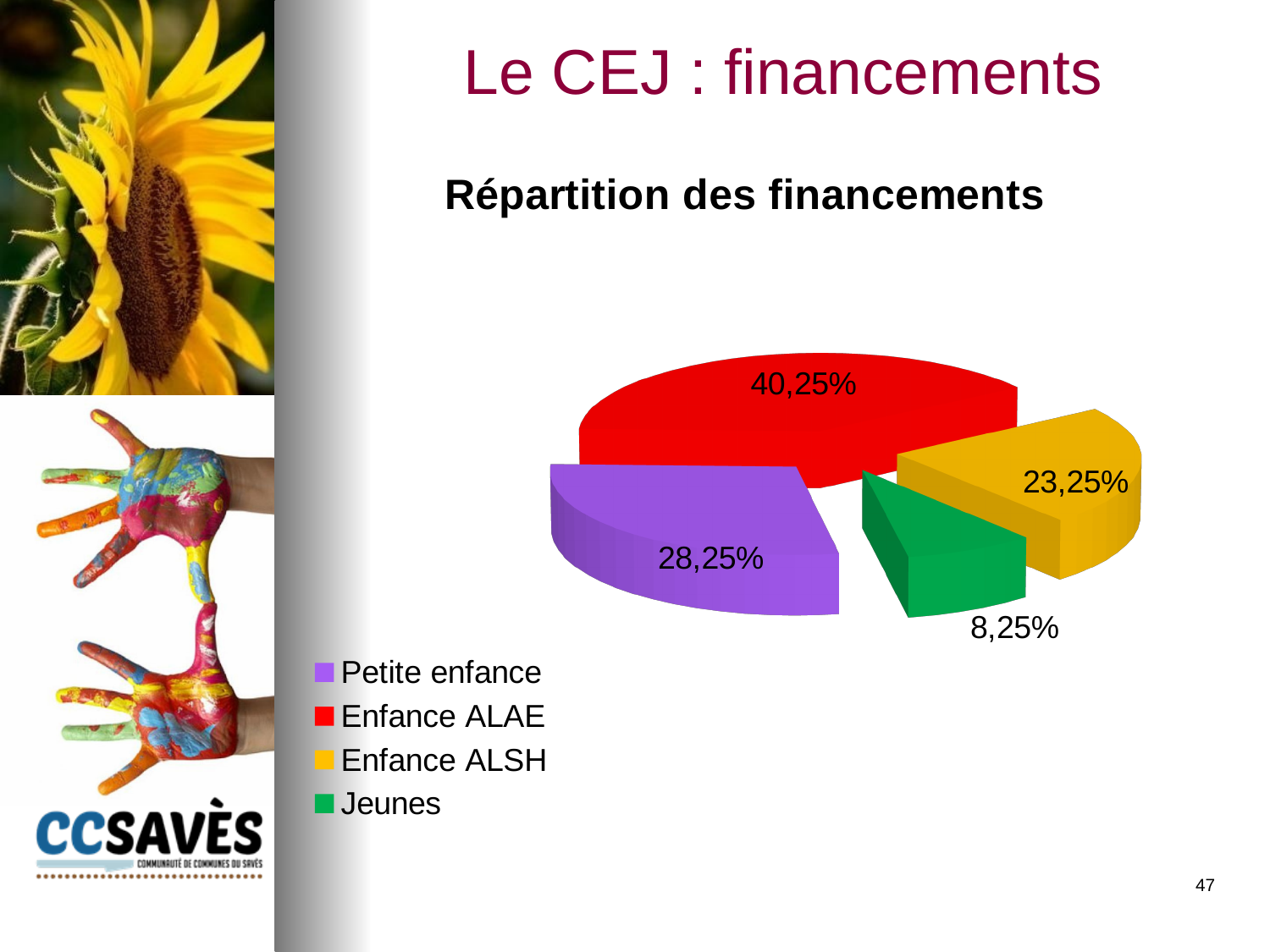
What is the share for Jeunes? 8,25% What is the share for Petite enfance? 28,25% What is the share for Enfance ALAE? 40,25% What is the difference between the shares of Enfance ALSH and Jeunes? 15 percentage points What is the difference between the shares of Enfance ALAE and Petite enfance? 12 percentage points How many slices does the pie chart have? 4 Which category has the largest share of the pie? Enfance ALAE What is the title of the pie chart? Répartition des financements Which category has the smallest share of the pie? Jeunes What is the share for Enfance ALSH? 23,25% What kind of chart is shown on the slide? pie chart Which is larger, the share for Petite enfance or the share for Enfance ALSH? Petite enfance